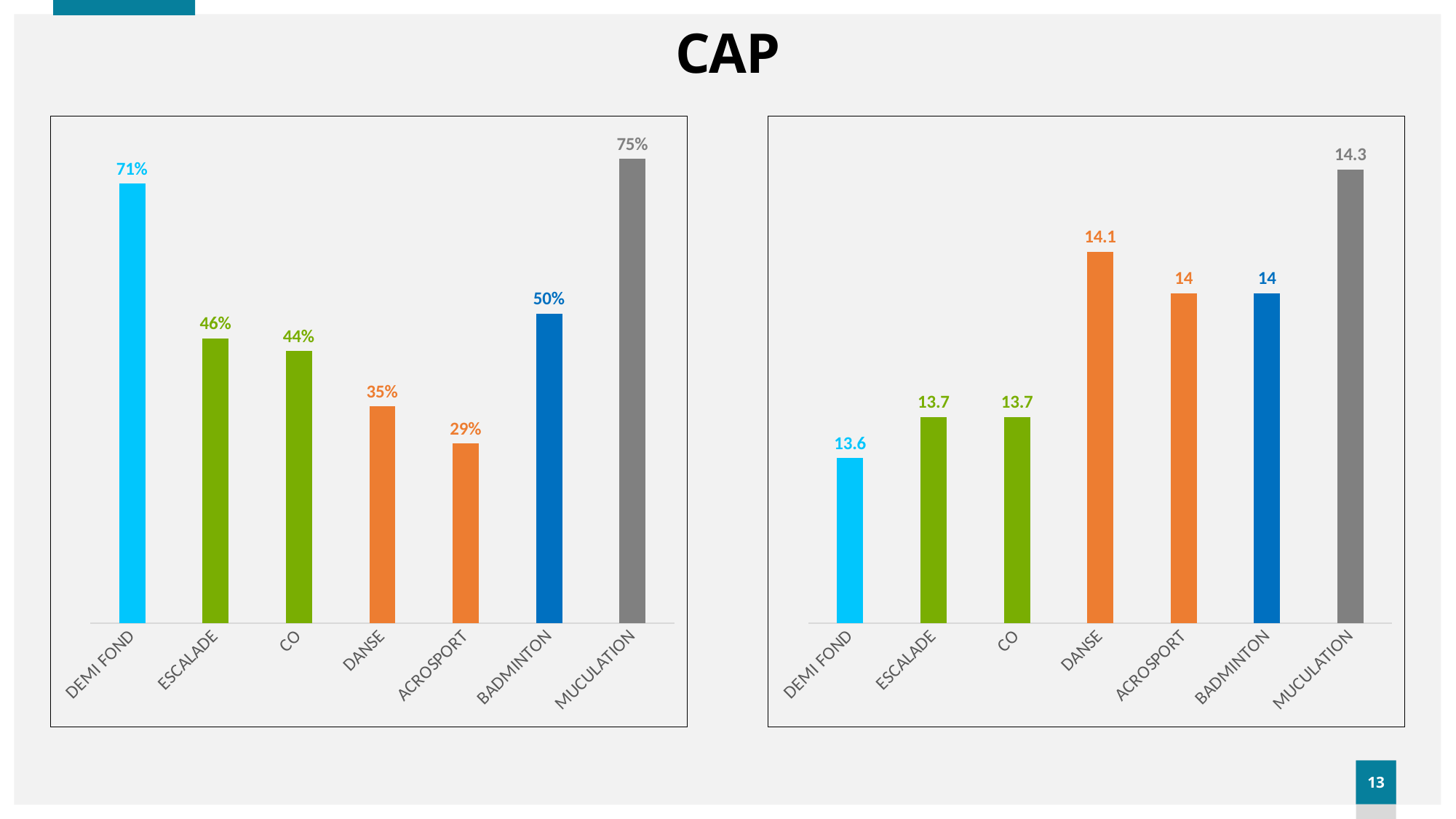
In the right chart, what is the value for DANSE? 14.1 In the left chart, which category has the highest value? MUCULATION In the right chart, which category has the lowest value? DEMI FOND What is the title of the slide? CAP In the left chart, which is larger, the value for ESCALADE or the value for CO? ESCALADE In the right chart, what is the difference between the values for MUCULATION and DEMI FOND? 0.7 In the left chart, which category has the lowest value? ACROSPORT In the right chart, which category has the highest value? MUCULATION In the left chart, what is the value for DEMI FOND? 71% How many categories are shown in the left chart? 7 In the left chart, what is the difference between the values for BADMINTON and DANSE? 15% What kind of chart is the right chart? Bar chart